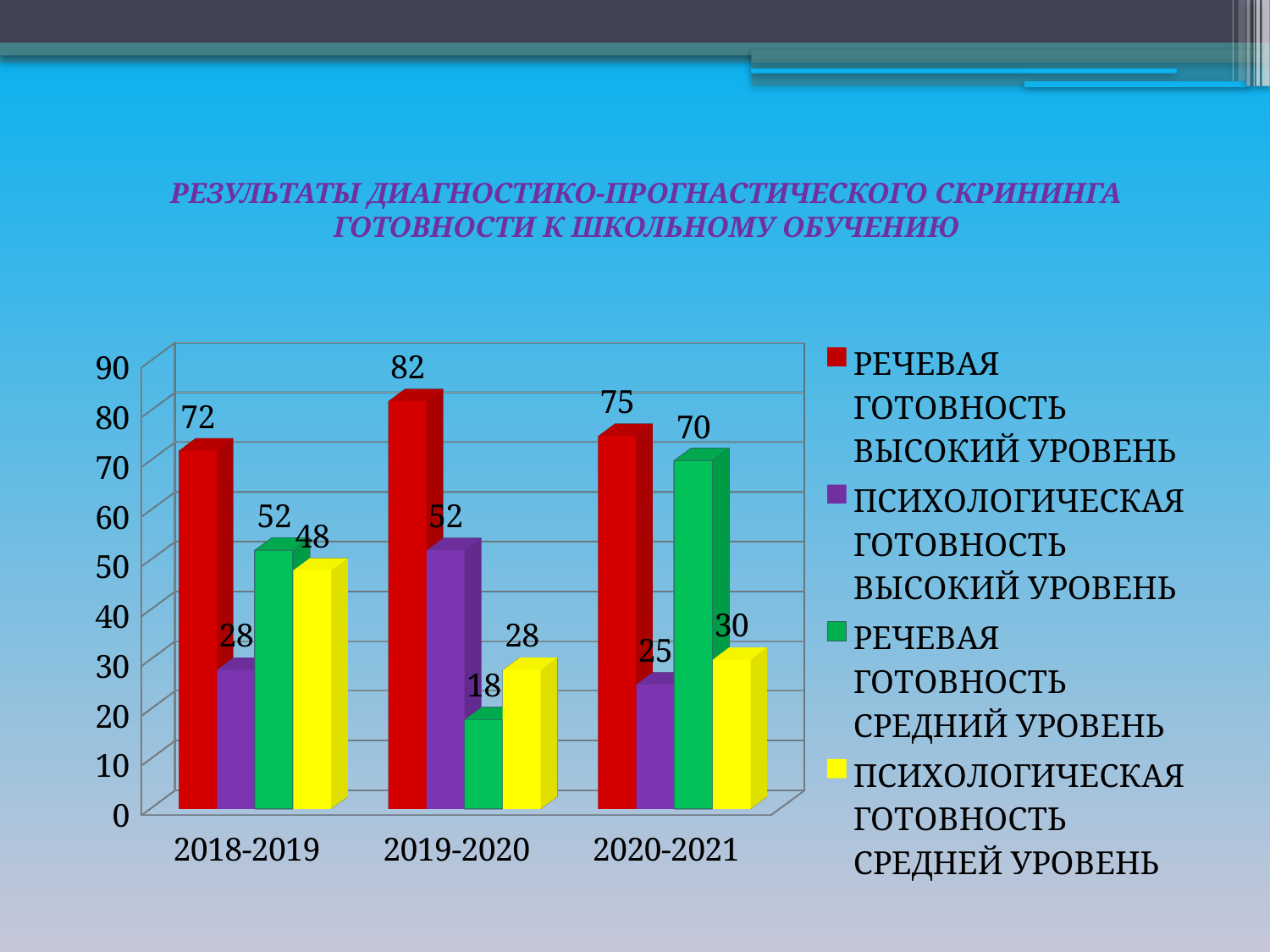
Which colour represents ПСИХОЛОГИЧЕСКАЯ ГОТОВНОСТЬ СРЕДНЕЙ УРОВЕНЬ in the legend? yellow What is the difference between РЕЧЕВАЯ ГОТОВНОСТЬ ВЫСОКИЙ УРОВЕНЬ and ПСИХОЛОГИЧЕСКАЯ ГОТОВНОСТЬ ВЫСОКИЙ УРОВЕНЬ in 2018-2019? 44 In which year is РЕЧЕВАЯ ГОТОВНОСТЬ ВЫСОКИЙ УРОВЕНЬ highest? 2019-2020 What is the value of ПСИХОЛОГИЧЕСКАЯ ГОТОВНОСТЬ СРЕДНЕЙ УРОВЕНЬ for 2018-2019? 48 What is the value of РЕЧЕВАЯ ГОТОВНОСТЬ ВЫСОКИЙ УРОВЕНЬ for 2019-2020? 82 What is the value of РЕЧЕВАЯ ГОТОВНОСТЬ СРЕДНИЙ УРОВЕНЬ for 2019-2020? 18 What is the value of ПСИХОЛОГИЧЕСКАЯ ГОТОВНОСТЬ ВЫСОКИЙ УРОВЕНЬ for 2020-2021? 25 In which year is РЕЧЕВАЯ ГОТОВНОСТЬ СРЕДНИЙ УРОВЕНЬ lowest? 2019-2020 Which is larger in 2020-2021: РЕЧЕВАЯ ГОТОВНОСТЬ ВЫСОКИЙ УРОВЕНЬ or РЕЧЕВАЯ ГОТОВНОСТЬ СРЕДНИЙ УРОВЕНЬ? РЕЧЕВАЯ ГОТОВНОСТЬ ВЫСОКИЙ УРОВЕНЬ What kind of chart is shown on the slide? bar chart How many categories are shown on the x axis? 3 How many series does the legend list? 4